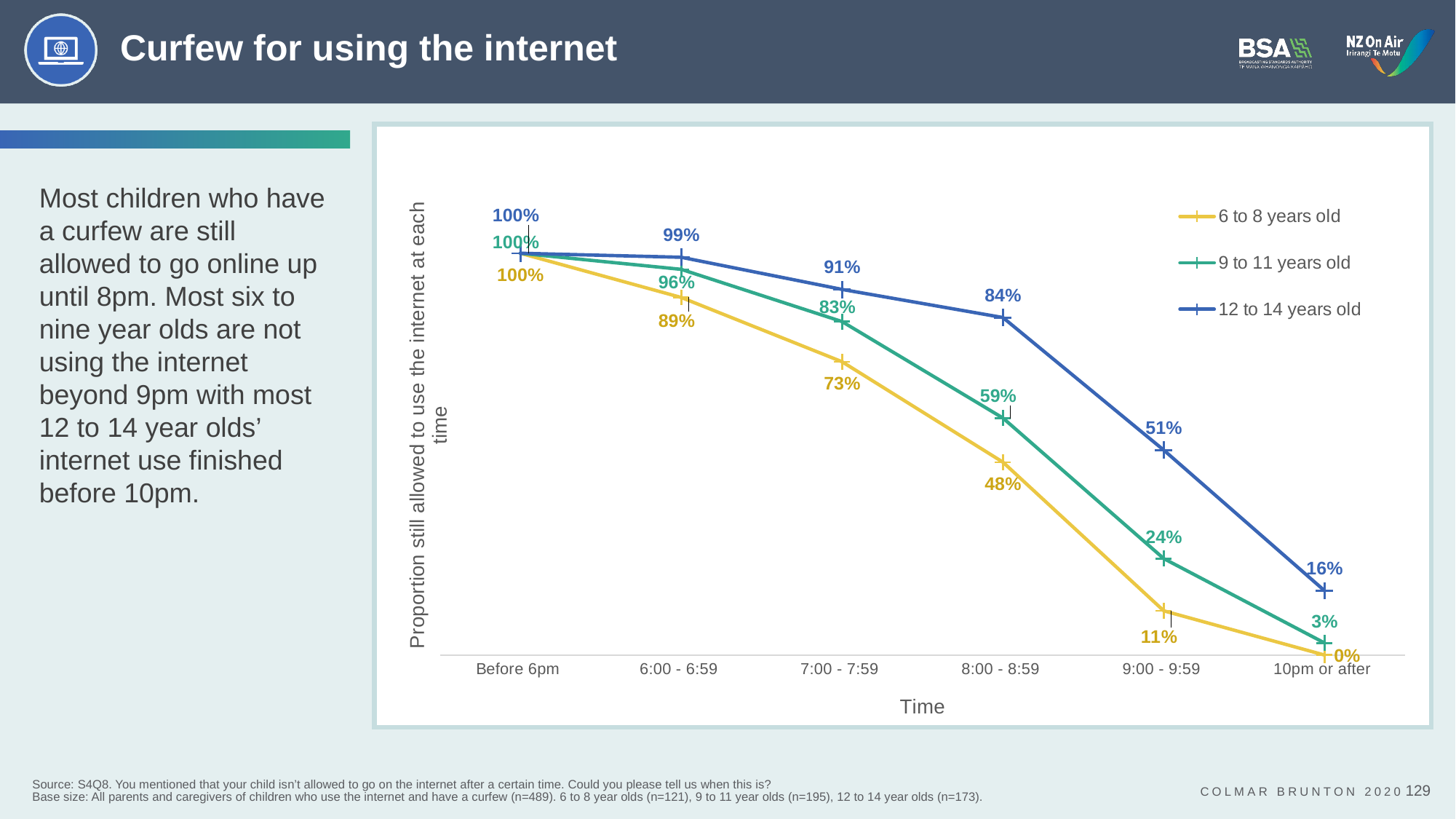
Which age group has the highest value at 8:00 - 8:59? 12 to 14 years old Which age group has the lowest value at 9:00 - 9:59? 6 to 8 years old What proportion of 9 to 11 year olds are still allowed to use the internet at 8:00 - 8:59? 59% Which is larger at 6:00 - 6:59: the value for 9 to 11 years old or for 6 to 8 years old? 9 to 11 years old What is the difference between the 12 to 14 years old and 6 to 8 years old values at 8:00 - 8:59? 36% What kind of chart is shown on the slide? Line chart What proportion of 6 to 8 year olds are still allowed to use the internet at 7:00 - 7:59? 73% What proportion of 12 to 14 year olds are still allowed to use the internet at 9:00 - 9:59? 51% Do the values for 12 to 14 years old rise or fall from Before 6pm to 10pm or after? Fall What is the value for 9 to 11 years old at 10pm or after? 3% How many time categories are shown on the x axis? 6 How many series does the legend list? 3